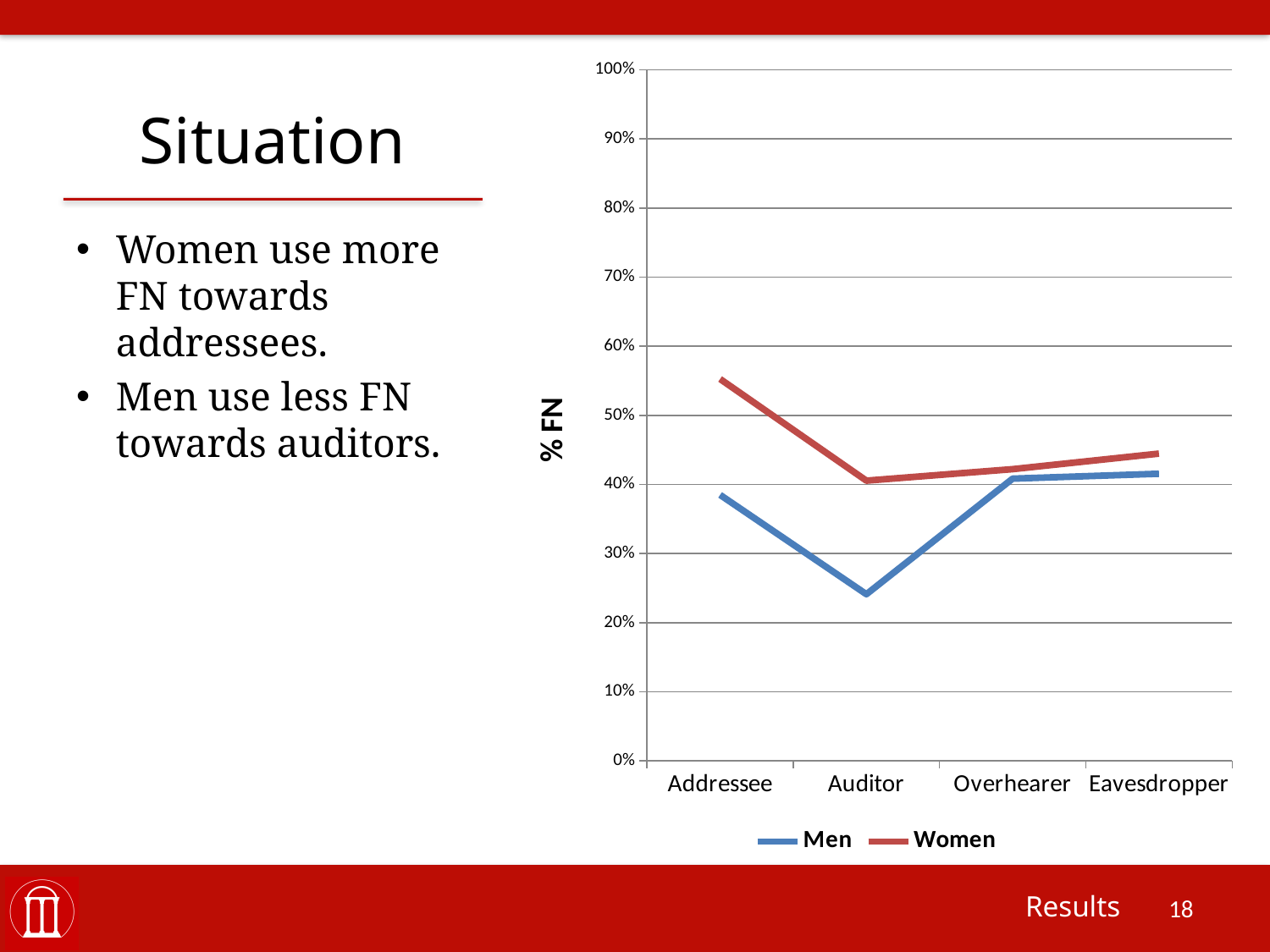
For which category is the Women line highest? Addressee Which colour represents the Women series in the legend? red For which category is the Men line lowest? Auditor What kind of chart is shown on the slide? line chart Is the value for Men at Addressee greater or less than 40%? less What is the label on the vertical axis? % FN At Addressee, which series has the higher value, Men or Women? Women How many categories are shown on the x axis? 4 How many series does the legend list? 2 Does the Men line rise or fall from Auditor to Overhearer? rise Is the value for Men at Auditor greater or less than 30%? less Is the value for Women at Addressee greater or less than 50%? greater